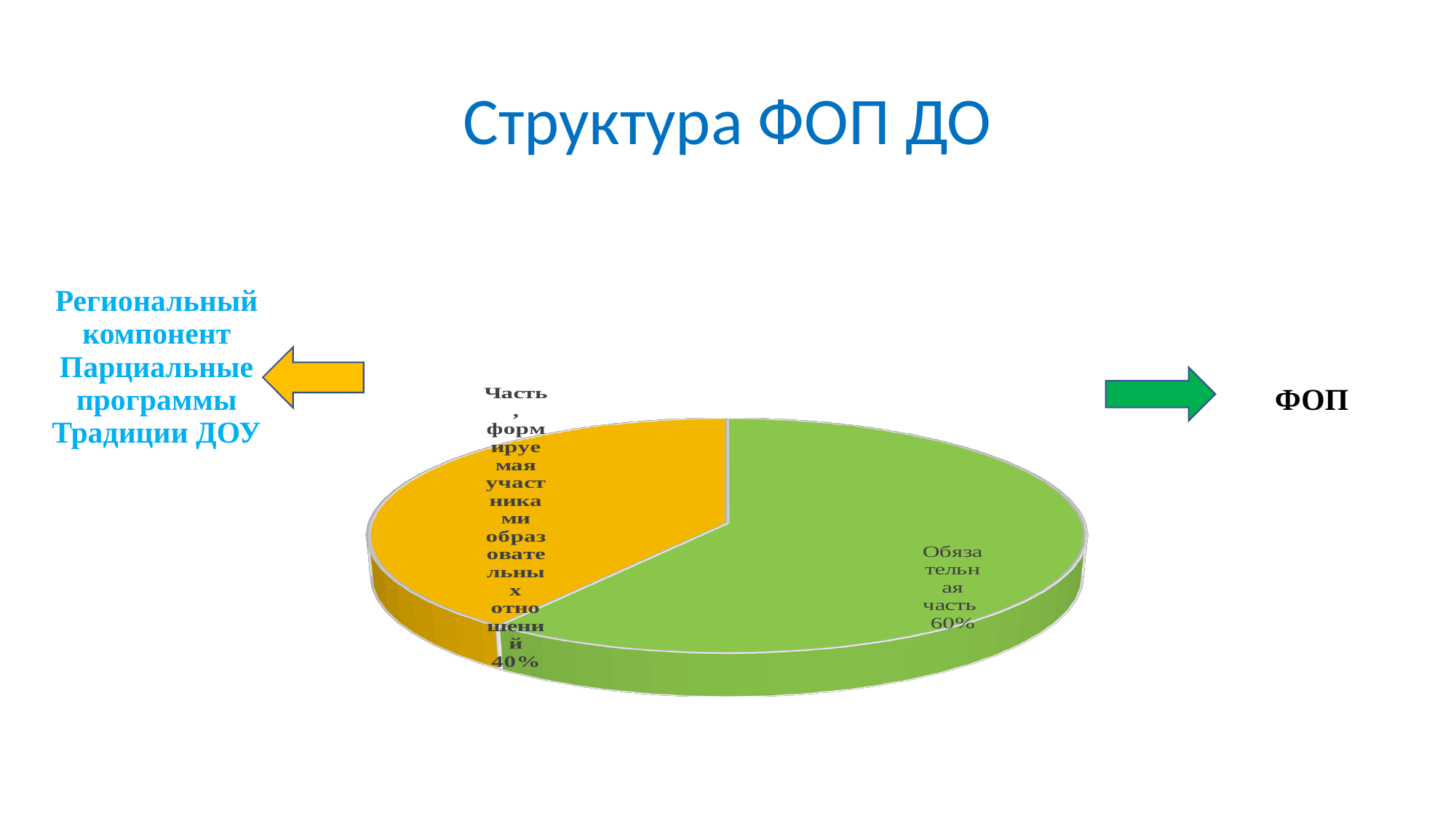
Which is larger: "Обязательная часть" or "Часть, формируемая участниками образовательных отношений"? Обязательная часть What share of the pie does "Обязательная часть" take? 60% How many slices does the pie chart have? 2 What kind of chart is shown on the slide? pie chart Which slice of the pie is the smallest? Часть, формируемая участниками образовательных отношений What is the title of the slide containing the pie chart? Структура ФОП ДО What is the difference in percentage points between "Обязательная часть" and "Часть, формируемая участниками образовательных отношений"? 20% What colour is the "Обязательная часть" slice? green Which slice of the pie is the largest? Обязательная часть What share of the pie does "Часть, формируемая участниками образовательных отношений" take? 40%